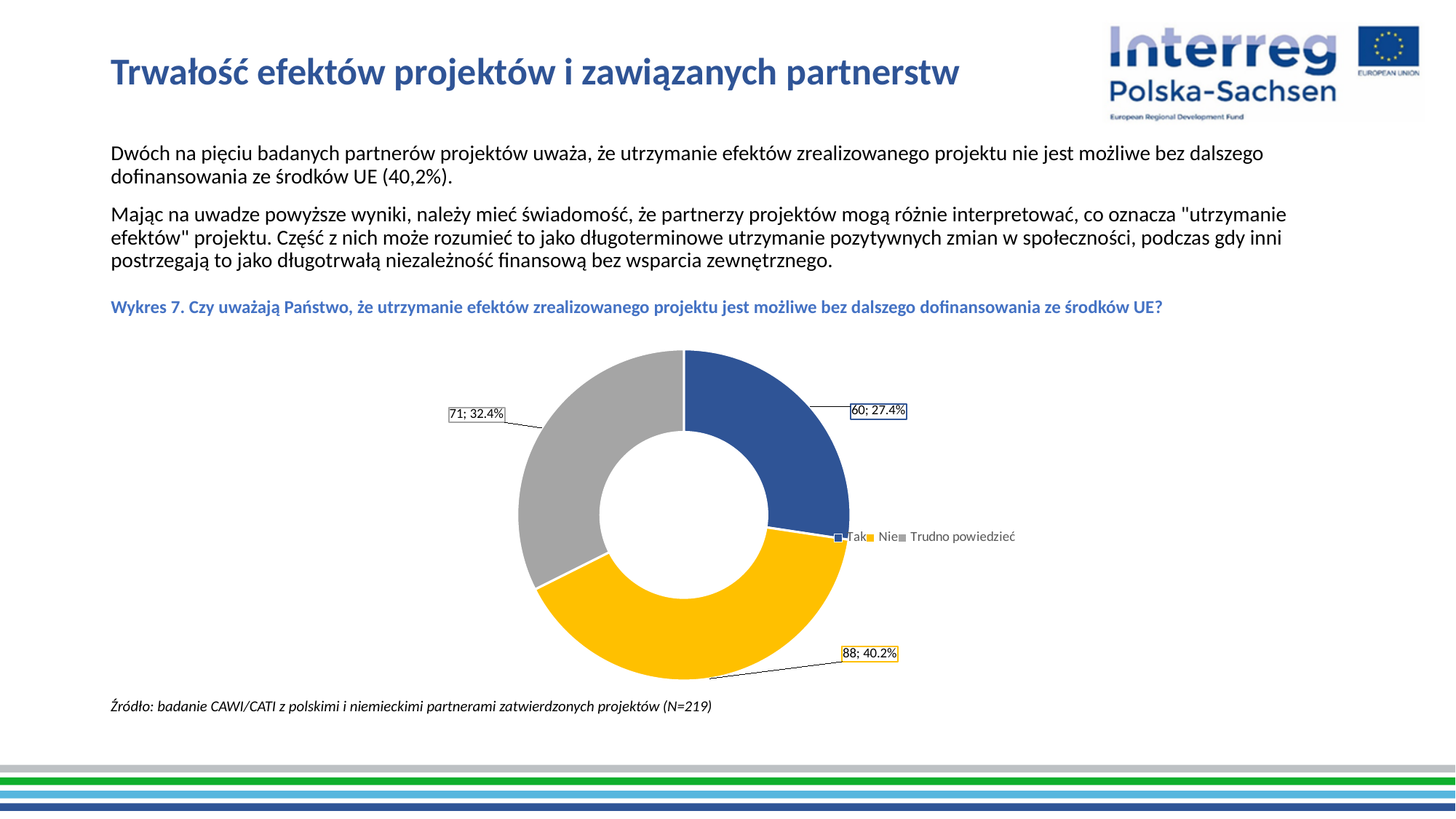
What share of the pie does 'Trudno powiedzieć' represent? 32.4% How many slices does the chart have? 3 What is the count shown for the 'Nie' slice? 88 Which is larger, the 'Trudno powiedzieć' slice or the 'Tak' slice? Trudno powiedzieć What kind of chart is shown on the slide? Pie chart (doughnut) What is the difference in count between 'Nie' and 'Tak'? 28 What colour is the 'Nie' slice? Yellow Which response has the smallest slice? Tak What is the count shown for the 'Trudno powiedzieć' slice? 71 Which response has the largest slice? Nie What percentage is shown for the 'Tak' slice? 27.4% How many entries does the legend list? 3